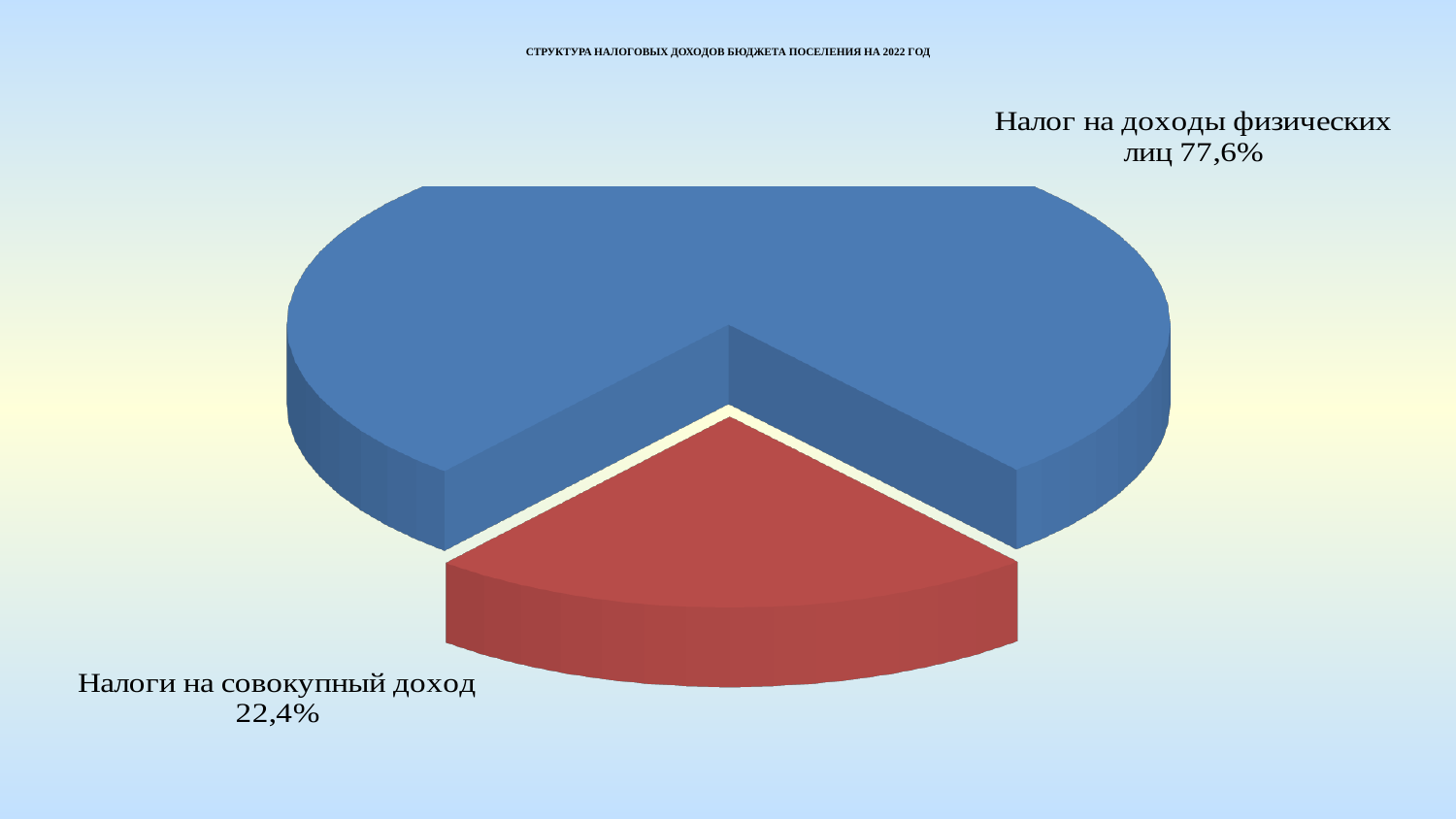
What kind of chart is shown on the slide? Pie chart Which slice is the smallest? Налоги на совокупный доход What share of the pie does "Налоги на совокупный доход" have? 22,4% What colour is the slice for "Налоги на совокупный доход"? Red What is the difference in percentage points between "Налог на доходы физических лиц" and "Налоги на совокупный доход"? 55,2 Which slice is the largest? Налог на доходы физических лиц What is the title of the chart? СТРУКТУРА НАЛОГОВЫХ ДОХОДОВ БЮДЖЕТА ПОСЕЛЕНИЯ НА 2022 ГОД Which is larger: the share for "Налоги на совокупный доход" or the share for "Налог на доходы физических лиц"? Налог на доходы физических лиц How many slices does the pie chart have? 2 What share of the pie does "Налог на доходы физических лиц" have? 77,6%